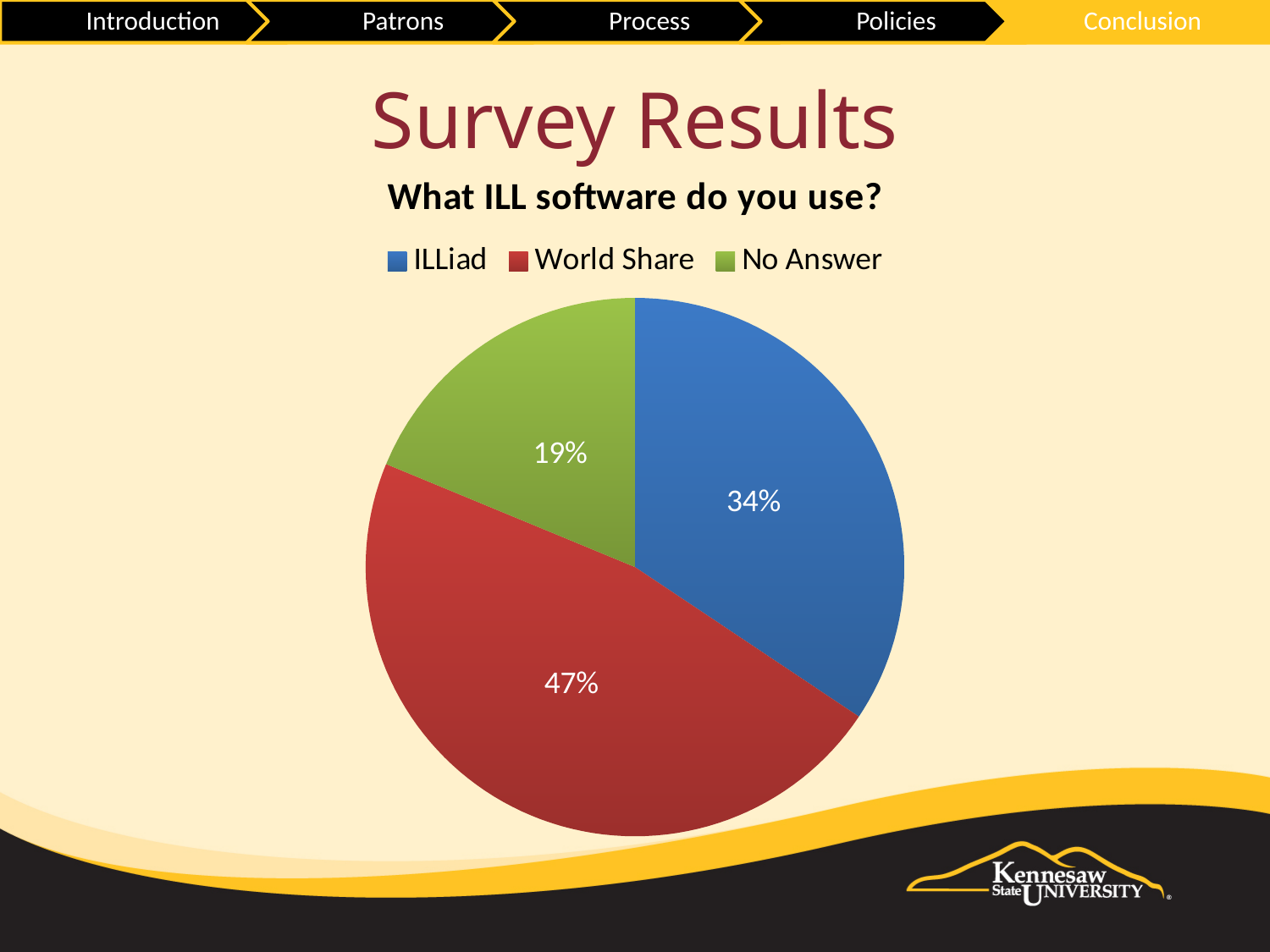
Which category has the smallest share of the pie? No Answer What percentage of respondents use World Share? 47% How many entries does the legend list? 3 What is the chart's title? What ILL software do you use? How many slices does the pie chart have? 3 What percentage of respondents gave No Answer? 19% What percentage of respondents use ILLiad? 34% What colour represents World Share in the pie chart? red What type of chart is shown on the slide? pie chart What is the difference in percentage points between World Share and ILLiad? 13 Which is larger, the share for ILLiad or the share for No Answer? ILLiad Which category has the largest share of the pie? World Share